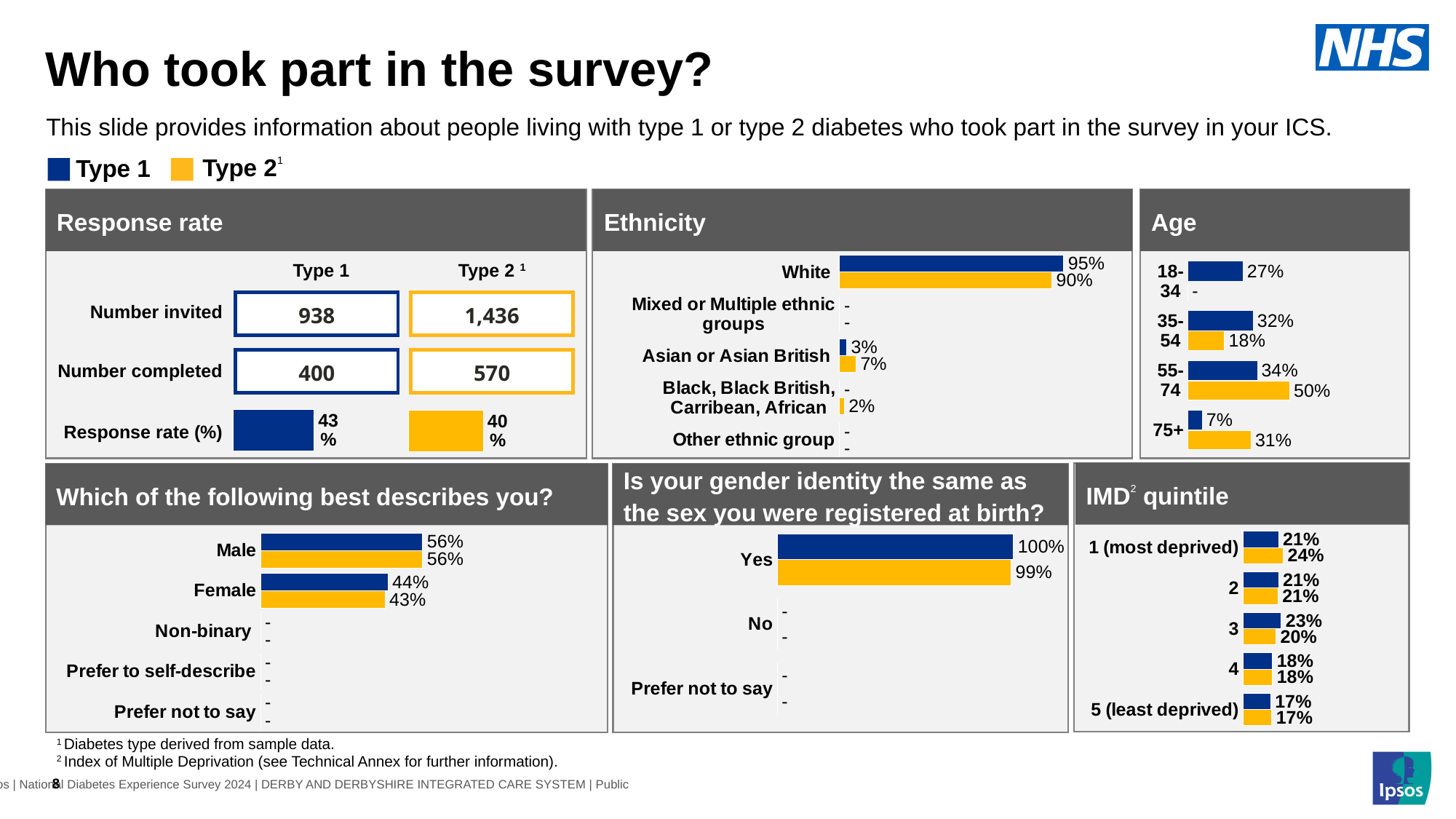
In the Ethnicity chart, what percentage of Type 1 respondents are White? 95% In the Response rate chart, which diabetes type has the higher response rate (%)? Type 1 In the Age chart, what percentage of Type 2 respondents are aged 55-74? 50% In the Age chart, which age group has the highest percentage of Type 1 respondents? 55-74 How many series does the legend at the top of the slide list? 2 In the 'Is your gender identity the same as the sex you were registered at birth?' chart, what percentage of Type 1 respondents answered Yes? 100% In the Age chart, what is the difference between the Type 2 and Type 1 percentages for the 75+ age group? 24% In the Ethnicity chart, what percentage of Type 2 respondents are Asian or Asian British? 7% In the IMD quintile chart, which quintile has the highest percentage of Type 2 respondents? 1 (most deprived) In the 'Which of the following best describes you?' chart, what percentage of Type 2 respondents are Female? 43% In the IMD quintile chart, what is the difference between the Type 1 and Type 2 percentages for quintile 3? 3% In the Response rate chart, what is the number completed for Type 2? 570